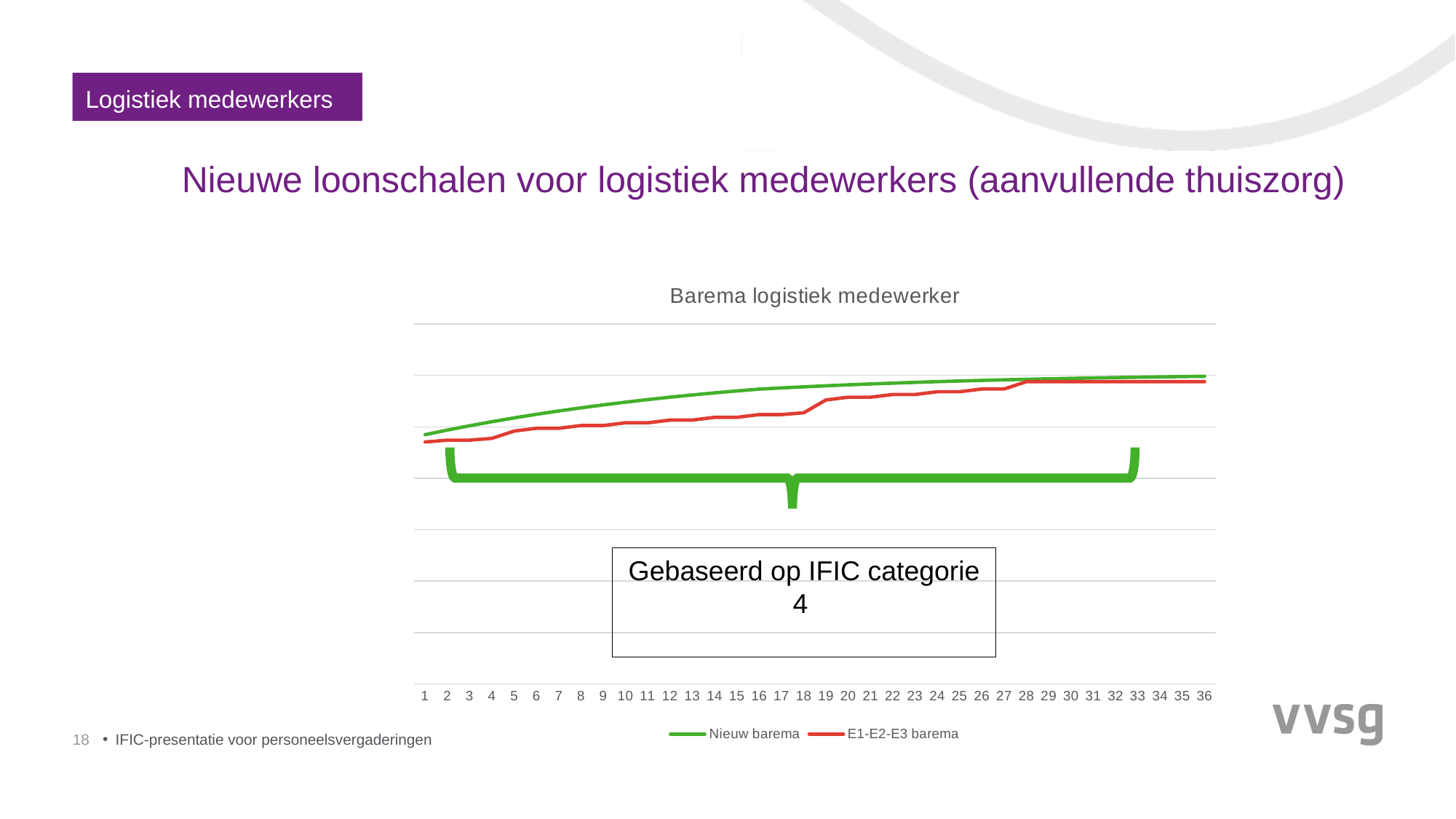
Does the E1-E2-E3 barema line rise or fall from x = 1 to x = 36? rise What is the last x-axis label on the chart? 36 Which series is drawn in green? Nieuw barema What kind of chart is shown on the slide? line chart At which x value does the Nieuw barema series reach its highest point? 36 At x = 17, which series has the lower value, Nieuw barema or E1-E2-E3 barema? E1-E2-E3 barema At which x value does the Nieuw barema series reach its lowest point? 1 How many series does the legend list? 2 How many points are there along the x axis of the chart? 36 Does the Nieuw barema line rise or fall from x = 1 to x = 36? rise At x = 10, which series has the higher value, Nieuw barema or E1-E2-E3 barema? Nieuw barema What is the title of the chart? Barema logistiek medewerker